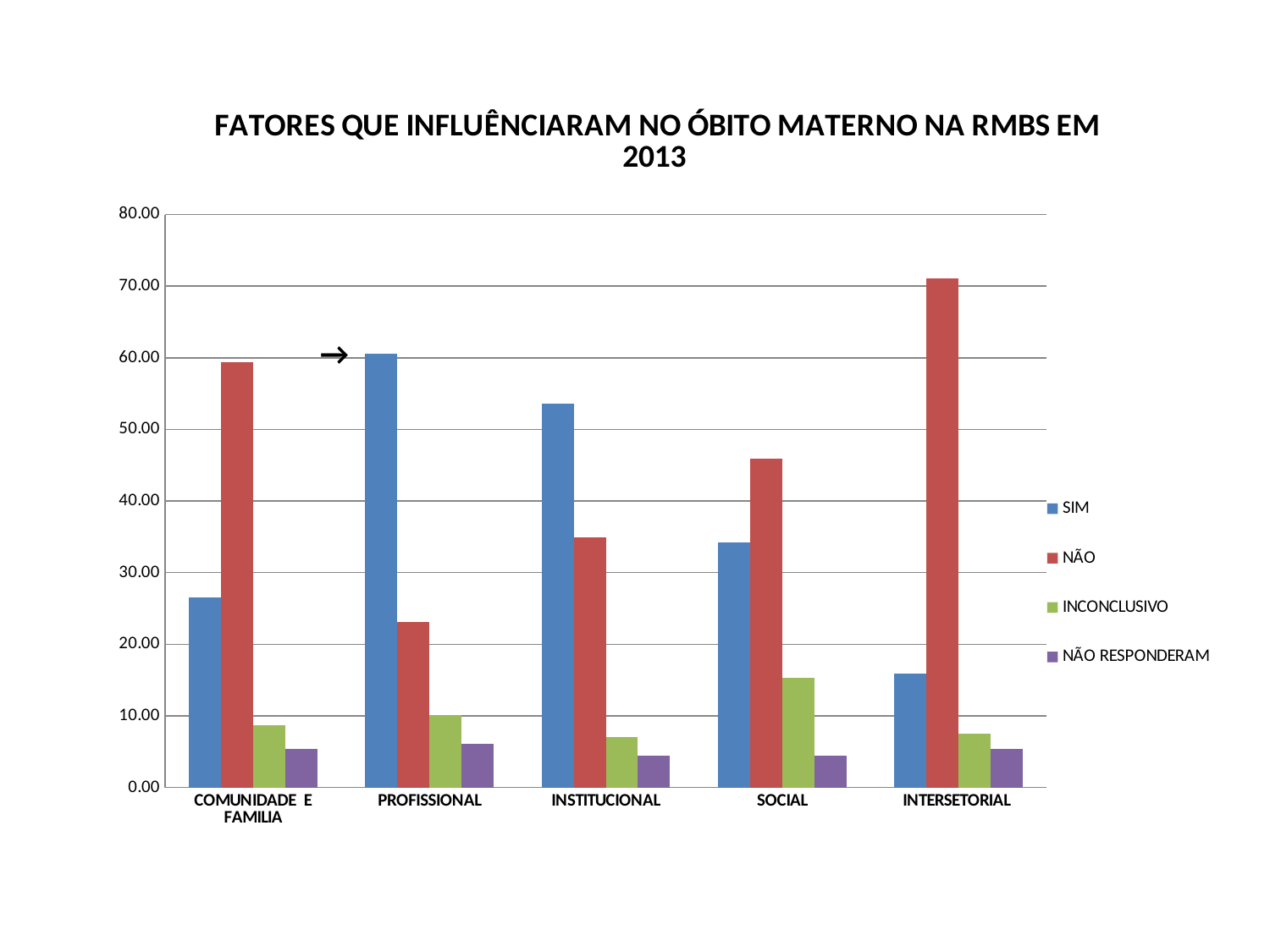
How many series does the legend list? 4 Which category has the highest value for INCONCLUSIVO? SOCIAL Is the value for SIM in PROFISSIONAL greater or less than 50? greater What kind of chart is shown on the slide? bar chart How many categories are shown on the x axis? 5 Is the value for SIM in COMUNIDADE E FAMILIA greater or less than 30? less Which category has the highest value for NÃO? INTERSETORIAL Is the value for NÃO in INTERSETORIAL greater or less than 60? greater Which category has the highest value for SIM? PROFISSIONAL In the SOCIAL category, which is larger: SIM or NÃO? NÃO Which category has the lowest value for SIM? INTERSETORIAL In the INSTITUCIONAL category, which is larger: SIM or NÃO? SIM